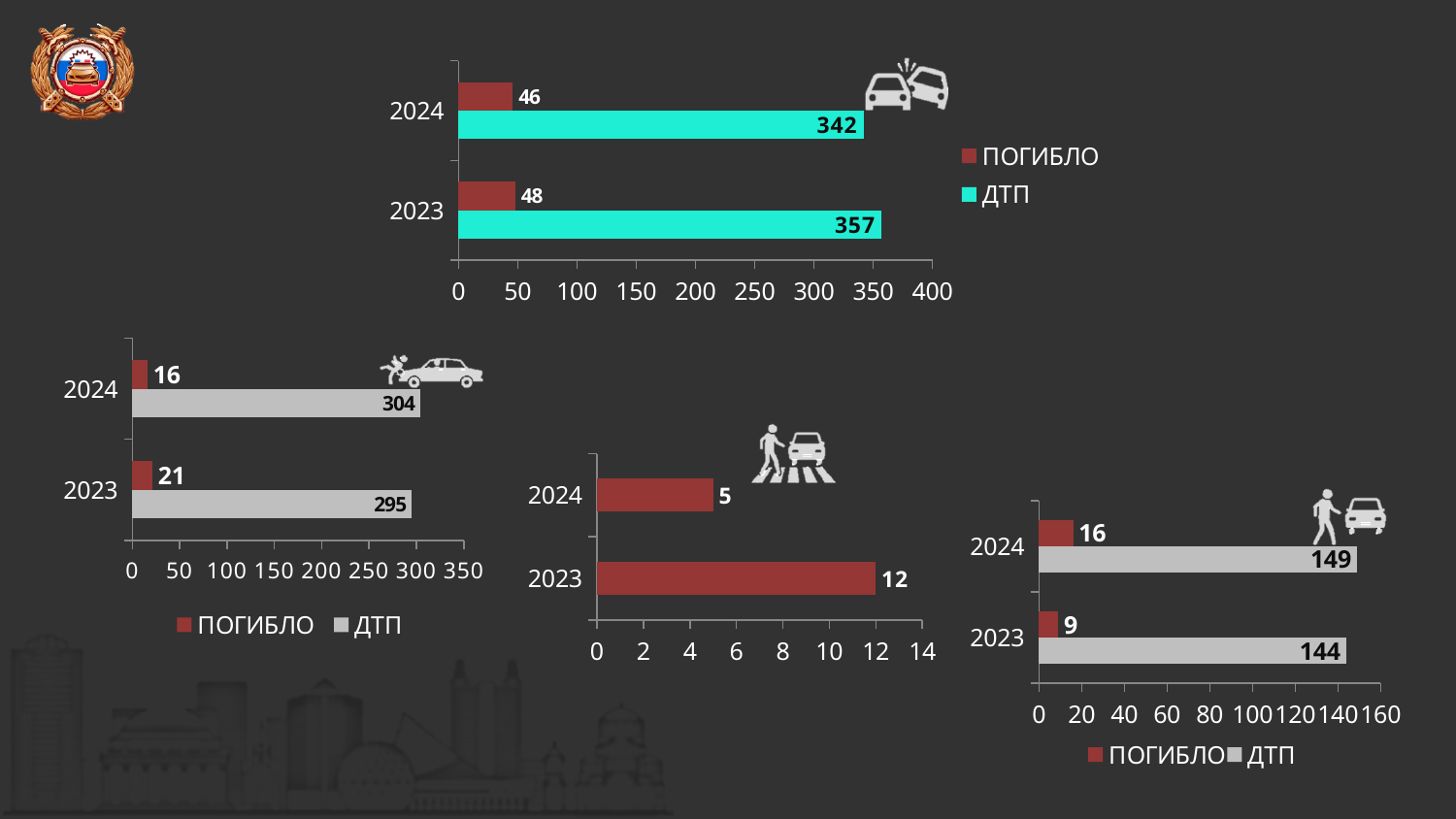
In the bottom-right chart, what is the ДТП value for 2023? 144 What kind of chart is the top chart? Bar chart In the top chart, which year has the higher ПОГИБЛО value, 2023 or 2024? 2023 In the top chart, what is the difference between the ДТП values for 2023 and 2024? 15 In the top chart, what is the ДТП value for 2024? 342 In the bottom-middle chart, which year has the lower value? 2024 In the bottom-left chart, what is the difference between the ПОГИБЛО values for 2023 and 2024? 5 In the bottom-right chart, what is the ПОГИБЛО value for 2024? 16 How many series does the legend of the bottom-right chart list? 2 In the top chart, what is the ПОГИБЛО value for 2023? 48 In the bottom-left chart, what is the ДТП value for 2024? 304 In the bottom-middle chart, what is the value for 2023? 12